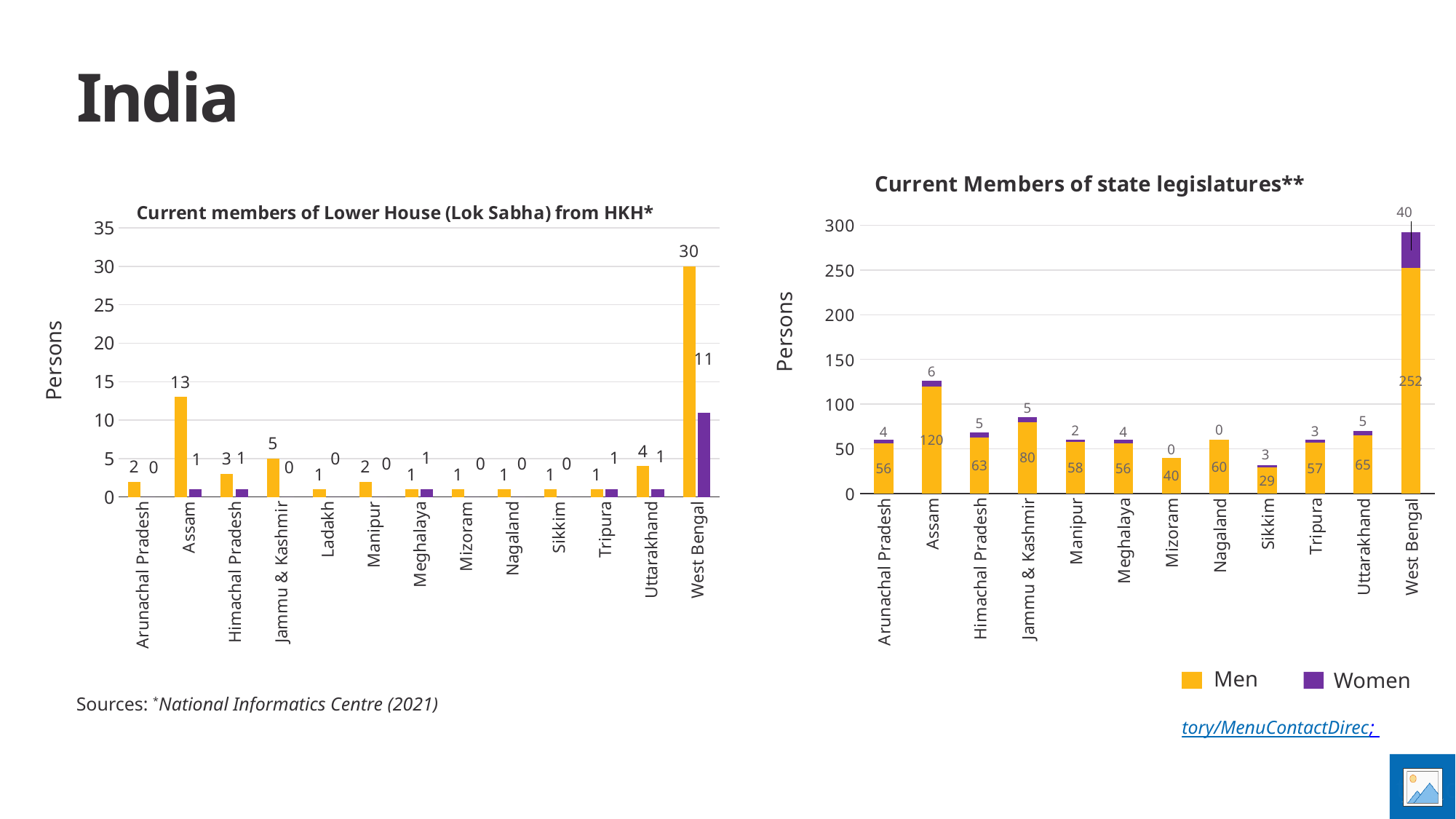
What kind of chart is the 'Current Members of state legislatures**' chart? Stacked bar chart In the 'Current Members of state legislatures**' chart, how many series does the legend list? 2 In the 'Current members of Lower House (Lok Sabha) from HKH*' chart, which state has the highest yellow bar? West Bengal In the 'Current Members of state legislatures**' chart, what is the total height of the stacked bar for West Bengal? 292 In the 'Current Members of state legislatures**' chart, how many states are shown on the x axis? 12 In the 'Current members of Lower House (Lok Sabha) from HKH*' chart, how many states are shown on the x axis? 13 In the 'Current Members of state legislatures**' chart, how many Women are shown for Assam? 6 In the 'Current members of Lower House (Lok Sabha) from HKH*' chart, what value is labelled on the purple bar for West Bengal? 11 In the 'Current Members of state legislatures**' chart, which state has the lowest number of Men? Sikkim In the 'Current members of Lower House (Lok Sabha) from HKH*' chart, what value is labelled on the yellow bar for Assam? 13 In the 'Current Members of state legislatures**' chart, how many Men are shown for West Bengal? 252 In the 'Current Members of state legislatures**' chart, what is the difference between the Men values for Assam and Jammu & Kashmir? 40